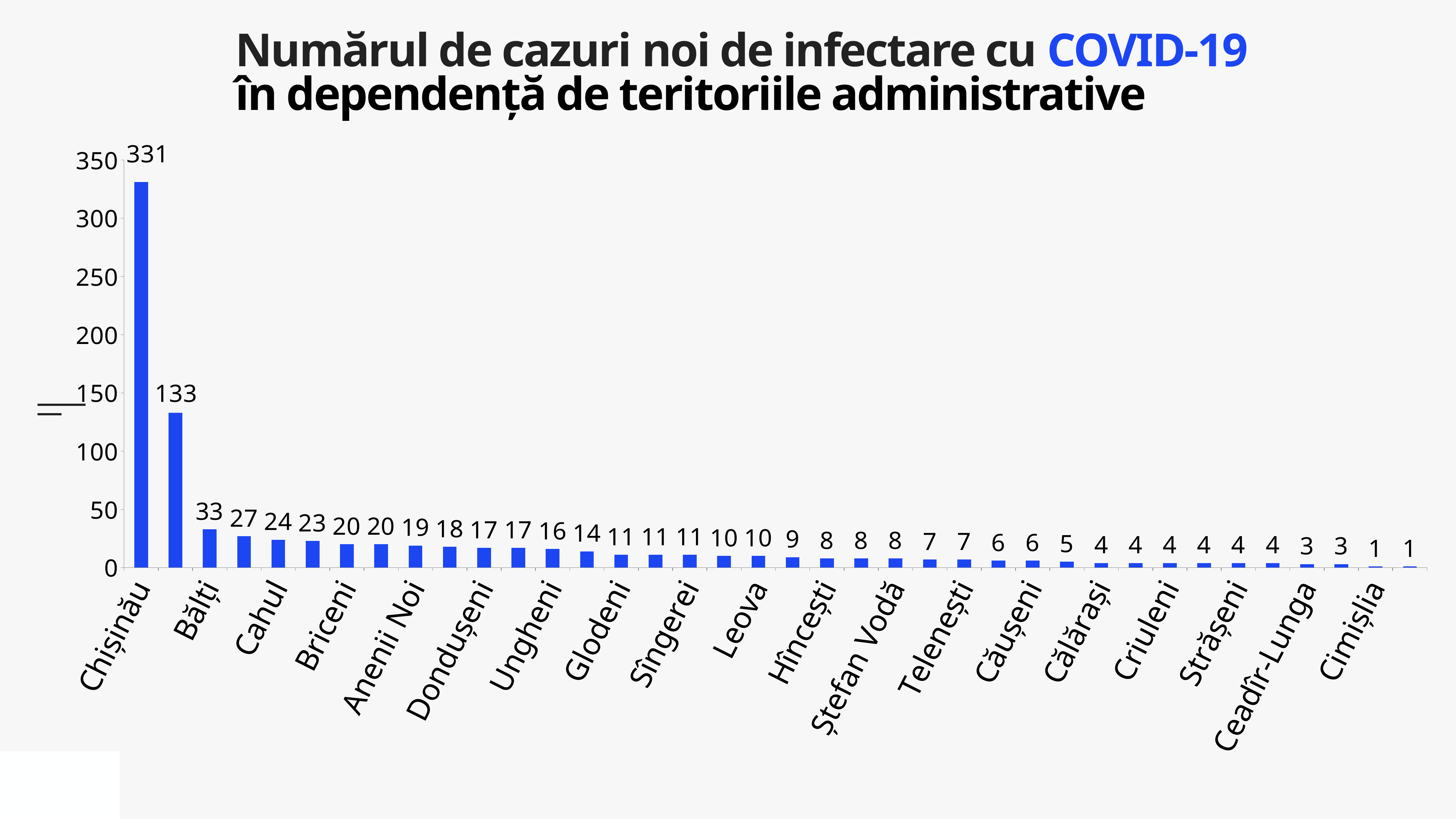
How many new COVID-19 cases are shown for Chișinău? 331 What is the title of the chart? Numărul de cazuri noi de infectare cu COVID-19 în dependență de teritoriile administrative Is the value for Chișinău greater or less than 300? greater What is the smallest value labelled on any bar in the chart? 1 Do the bar values rise or fall from left to right along the x axis? fall Which administrative territory has the highest number of new COVID-19 cases? Chișinău What colour are the bars in the chart? blue What kind of chart is shown on the slide? bar chart What is the difference between the tallest bar (331) and the second tallest bar (133)? 198 What is the value of the second tallest bar in the chart? 133 What is the highest tick value shown on the y axis? 350 Is the value of the second bar (133) greater or less than 150? less